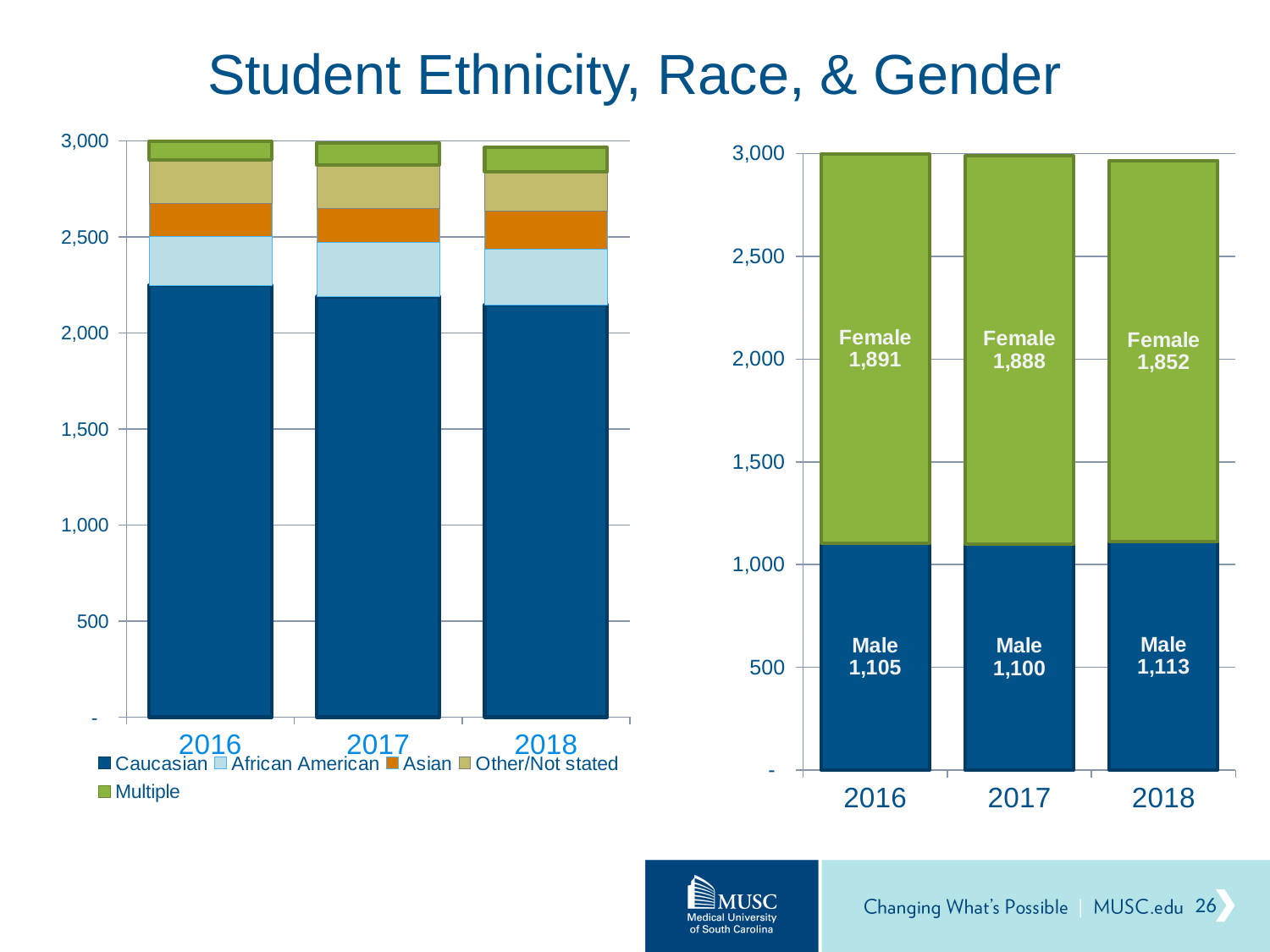
On the right-hand chart, which year has the highest Female value? 2016 On the right-hand chart, which year has the lowest Male value? 2017 On the right-hand chart, what is the total of the stacked bar for 2017? 2,988 What kind of chart is the left-hand chart? stacked bar chart On the right-hand chart, what is the Female value for 2018? 1,852 On the left-hand chart, how many series does the legend list? 5 On the left-hand chart, is the Caucasian value for 2018 greater or less than 2,000? greater On the right-hand chart, what is the difference between the Female values for 2016 and 2018? 39 On the right-hand chart, do the Female values rise or fall from 2016 to 2018? fall On the right-hand chart, what is the Male value for 2018? 1,113 On the right-hand chart, is the Male value for 2016 larger or smaller than the Male value for 2017? larger On the right-hand chart, what is the Female value for 2016? 1,891